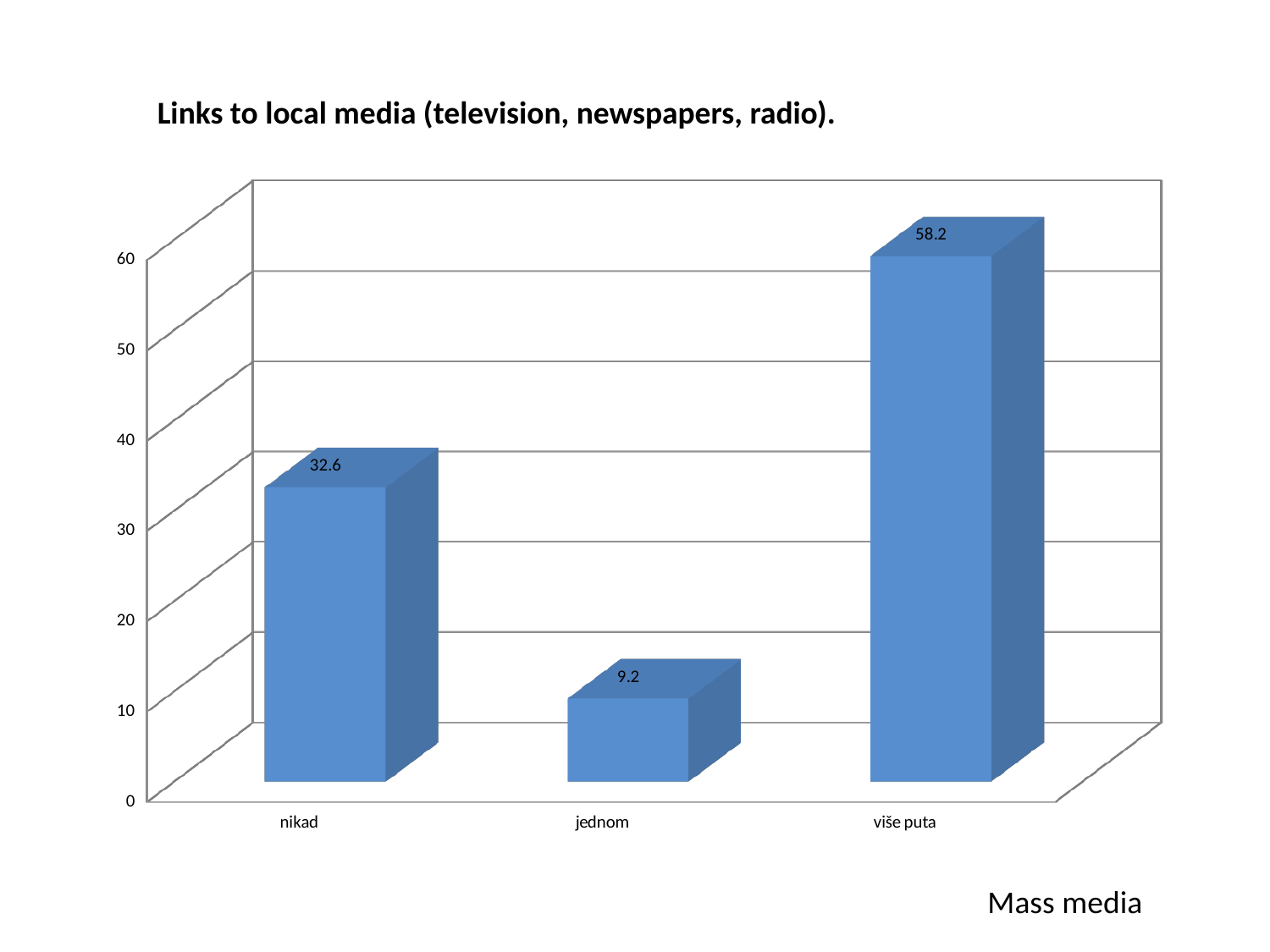
Which category has the lowest value? jednom Which is larger, the value for nikad or the value for jednom? nikad What is the value for nikad? 32.6 What is the title of the chart? Links to local media (television, newspapers, radio). What kind of chart is shown on the slide? bar chart What is the value for jednom? 9.2 Is the value for više puta greater or less than 50? greater What is the value for više puta? 58.2 Which category has the highest value? više puta How many categories are shown on the x axis? 3 What is the difference between the values for nikad and jednom? 23.4 What is the difference between the values for više puta and nikad? 25.6